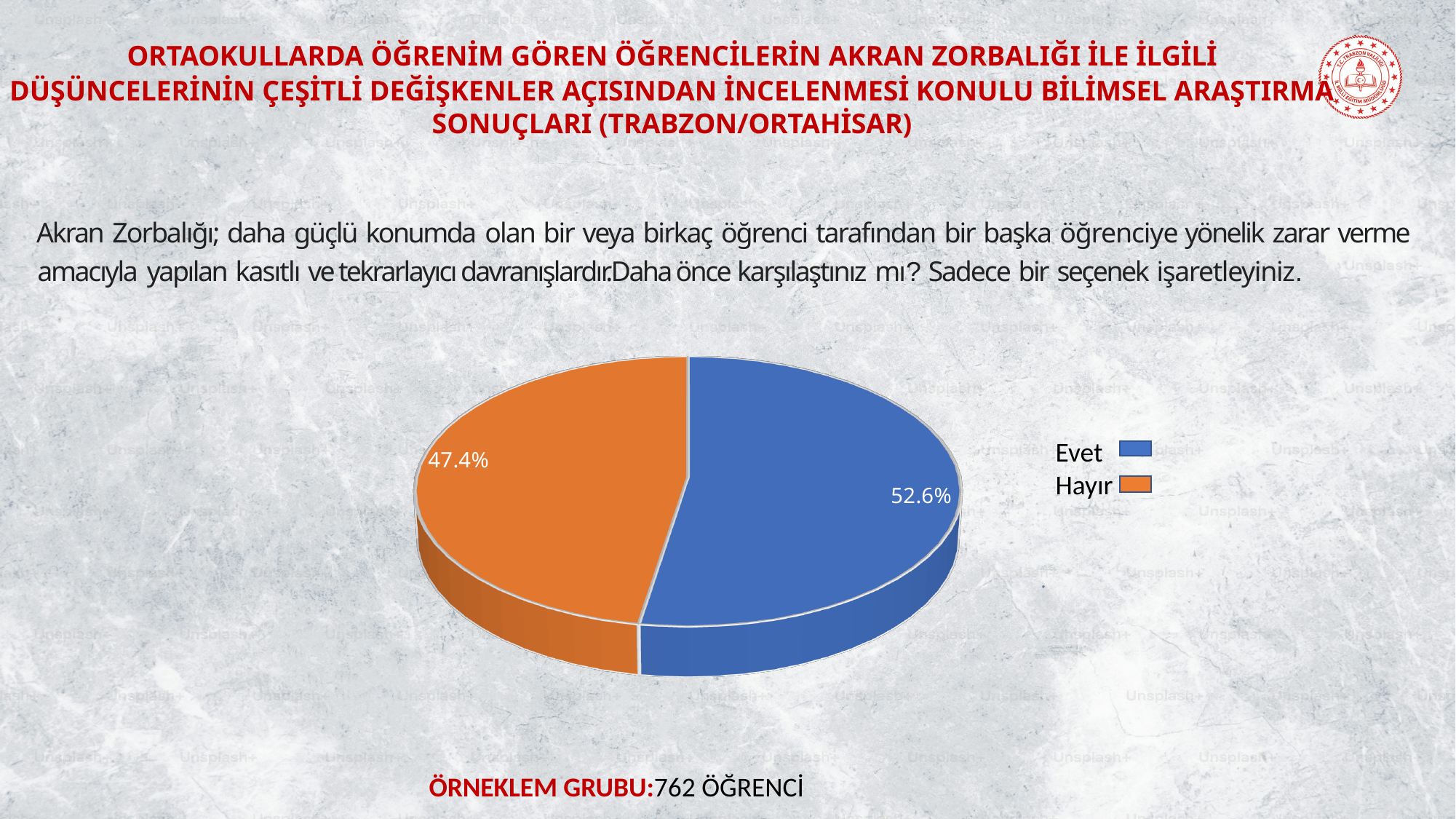
What percentage of the pie is labelled for Evet? 52.6% Which slice of the pie is the largest? Evet How many slices does the pie chart have? 2 What is the difference in percentage points between the Evet and Hayır slices? 5.2 Which is larger, the Evet slice or the Hayır slice? Evet What colour is the Hayır slice in the pie chart? orange What colour is the Evet slice in the pie chart? blue What percentage of the pie is labelled for Hayır? 47.4% What share of the pie does the Hayır slice represent? 47.4% How many entries does the legend list? 2 What kind of chart is shown on the slide? pie chart Which slice of the pie is the smallest? Hayır